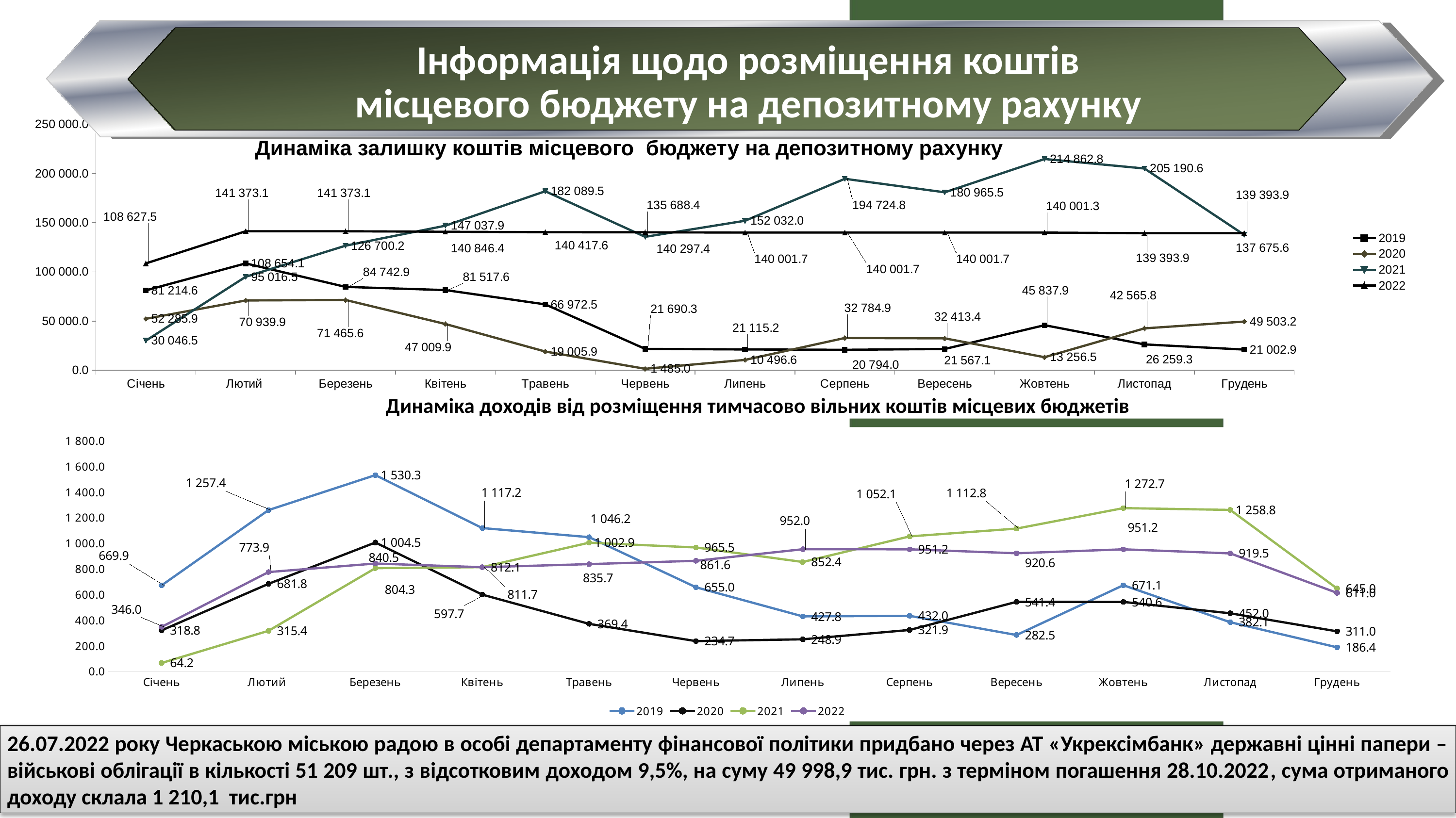
On the chart 'Динаміка залишку коштів місцевого бюджету на депозитному рахунку', what is the difference between the 2022 and 2019 values in Січень? 27 412.9 On the chart 'Динаміка залишку коштів місцевого бюджету на депозитному рахунку', what is the value for 2020 in Червень? 1 485.0 On the chart 'Динаміка залишку коштів місцевого бюджету на депозитному рахунку', in which month does the 2021 series reach its highest value? Жовтень On the chart 'Динаміка доходів від розміщення тимчасово вільних коштів місцевих бюджетів', how many months are shown on the x axis? 12 On the chart 'Динаміка залишку коштів місцевого бюджету на депозитному рахунку', in which month is the 2019 series lowest? Серпень On the chart 'Динаміка залишку коштів місцевого бюджету на депозитному рахунку', what is the value for 2021 in Жовтень? 214 862.8 What kind of chart is 'Динаміка доходів від розміщення тимчасово вільних коштів місцевих бюджетів'? line chart On the chart 'Динаміка доходів від розміщення тимчасово вільних коштів місцевих бюджетів', does the 2019 series rise or fall from Березень to Грудень? fall On the chart 'Динаміка доходів від розміщення тимчасово вільних коштів місцевих бюджетів', what is the value for 2019 in Березень? 1 530.3 On the chart 'Динаміка доходів від розміщення тимчасово вільних коштів місцевих бюджетів', which is larger in Жовтень: the 2021 value or the 2022 value? 2021 On the chart 'Динаміка доходів від розміщення тимчасово вільних коштів місцевих бюджетів', what is the value for 2021 in Січень? 64.2 On the chart 'Динаміка залишку коштів місцевого бюджету на депозитному рахунку', how many series does the legend list? 4